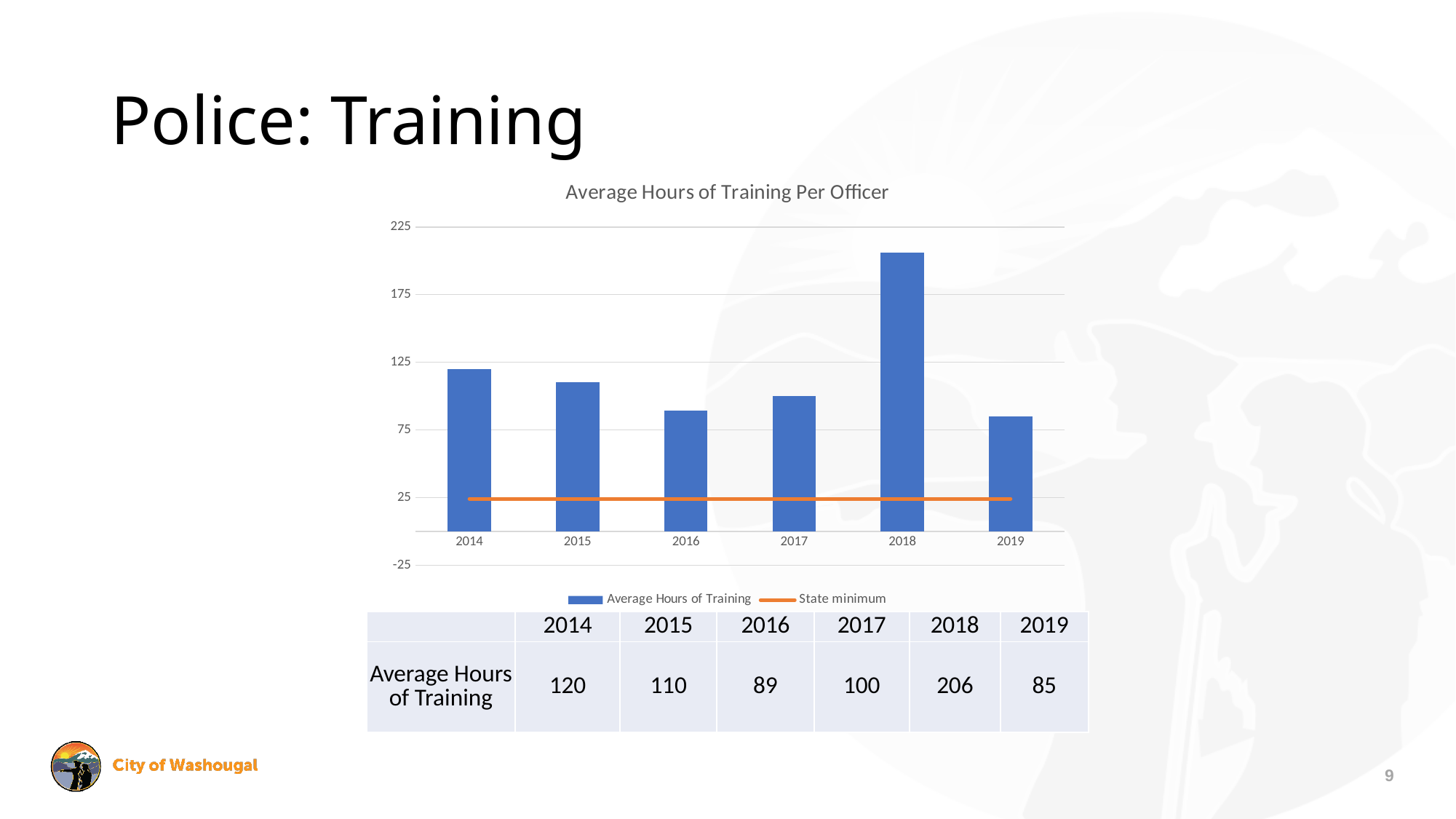
What is the title of the chart? Average Hours of Training Per Officer What is the difference in average hours of training between 2014 and 2015? 10 How many years are shown on the x axis of the chart? 6 What kind of chart is used to show the average hours of training? bar chart What is the difference in average hours of training between 2018 and 2019? 121 Which year has the highest average hours of training per officer? 2018 What is the average hours of training per officer in 2018? 206 What is the average hours of training per officer in 2016? 89 Which year had more average hours of training, 2015 or 2017? 2015 How many series does the chart legend list? 2 Is the State minimum line greater or less than 75 hours? less Which year has the lowest average hours of training per officer? 2019